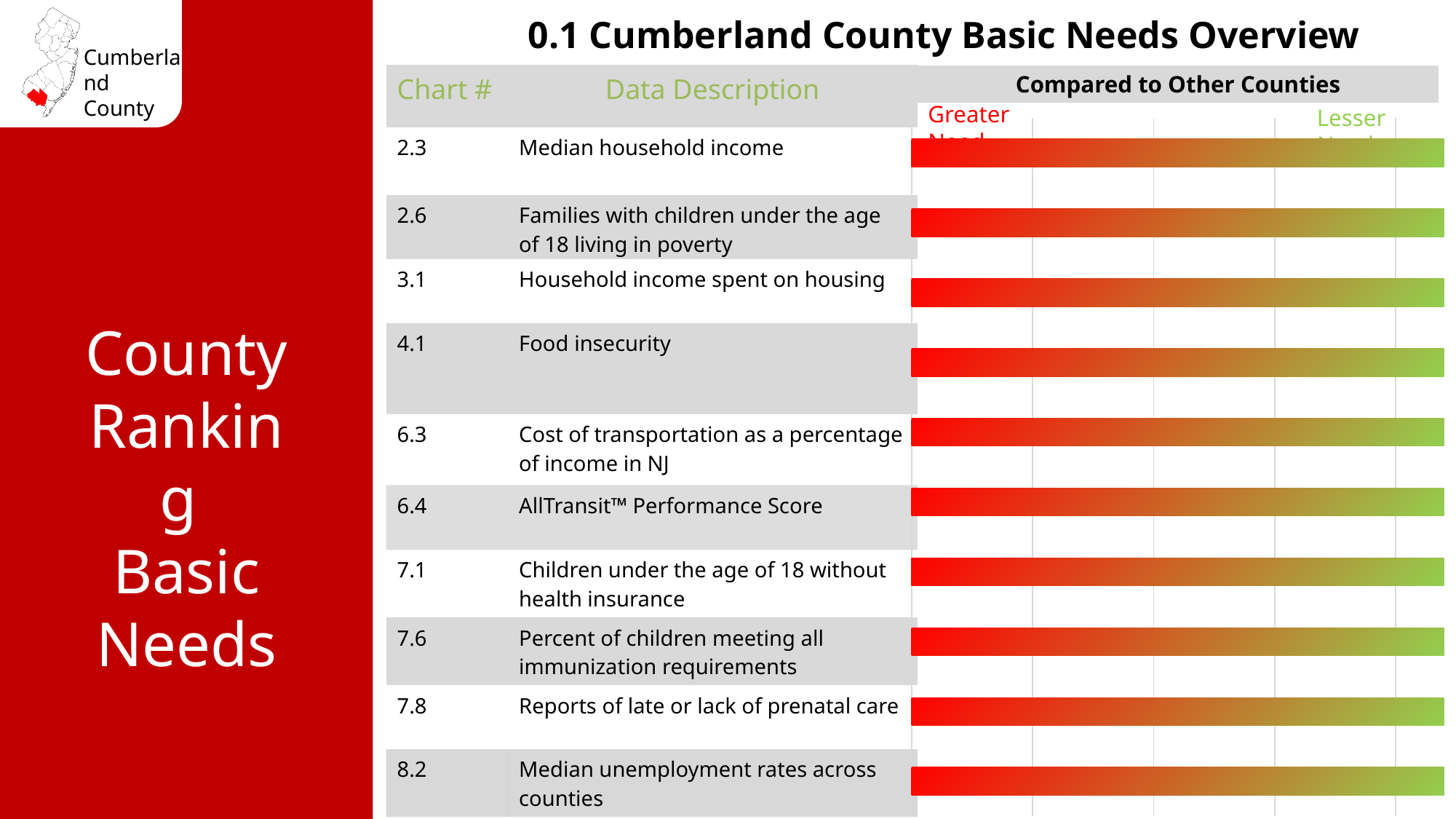
What kind of chart is shown in the 'Compared to Other Counties' column? bar chart What is the heading of the column containing the colored bars? Compared to Other Counties Which chart number is listed for 'Median household income'? 2.3 How many data description rows (bars) are shown on the slide? 10 Which data description is listed for chart number 8.2? Median unemployment rates across counties Which chart number is listed for 'Food insecurity'? 4.1 Which data description is listed for chart number 6.4? AllTransit™ Performance Score Which chart number is listed for 'Reports of late or lack of prenatal care'? 7.8 What is the title of the slide's chart overview? 0.1 Cumberland County Basic Needs Overview